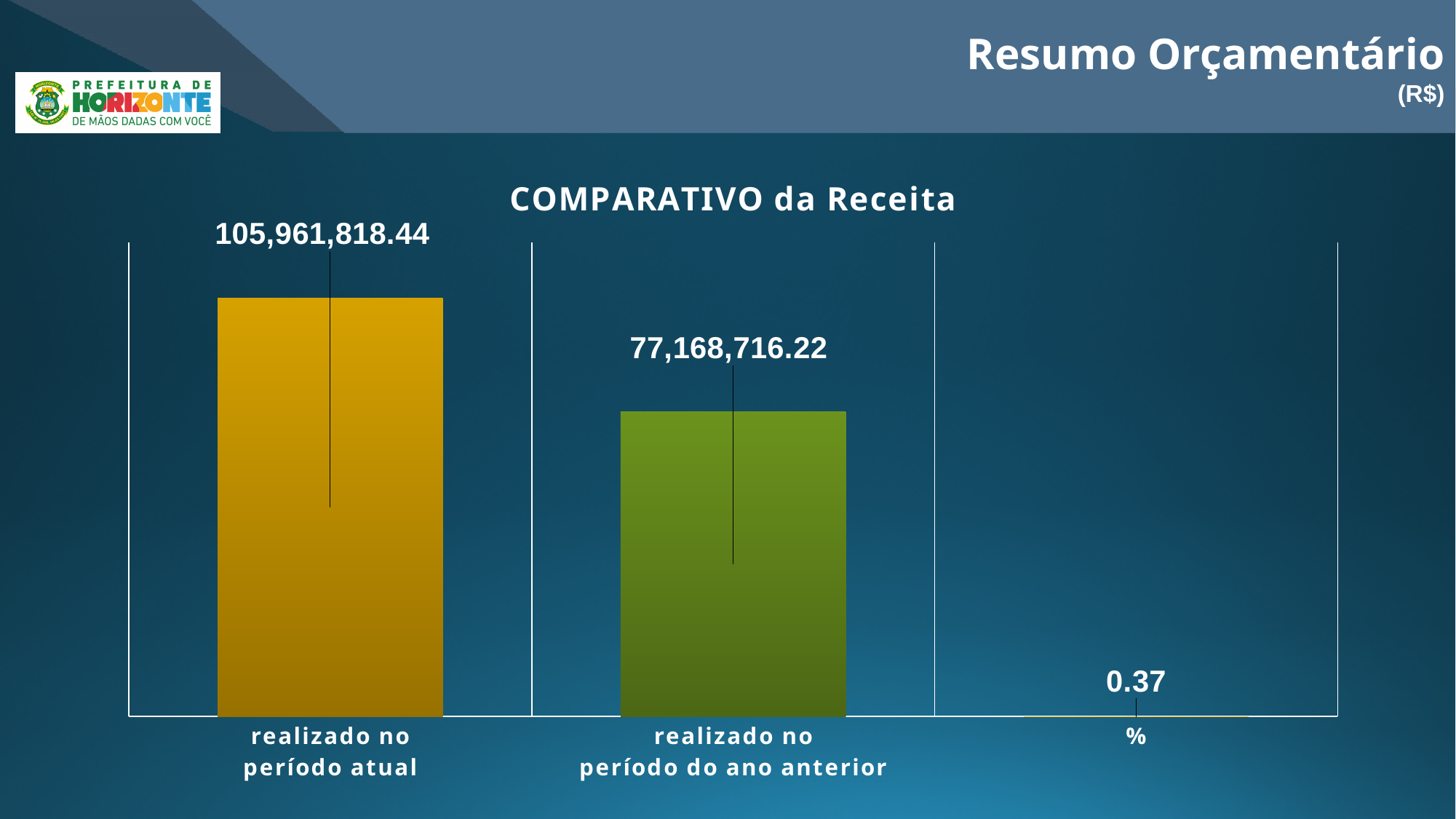
What is the value for 'realizado no período atual'? 105,961,818.44 Which category has the highest value? realizado no período atual What is the title of the chart? COMPARATIVO da Receita What is the value shown for the '%' category? 0.37 How many categories are shown on the x axis of the chart? 3 What kind of chart is shown on the slide? bar chart Which is larger: the value for 'realizado no período atual' or 'realizado no período do ano anterior'? realizado no período atual What is the value for 'realizado no período do ano anterior'? 77,168,716.22 Which category has the lowest value? % What colour is the bar for 'realizado no período do ano anterior'? green What is the difference between the value for 'realizado no período atual' and 'realizado no período do ano anterior'? 28,793,102.22